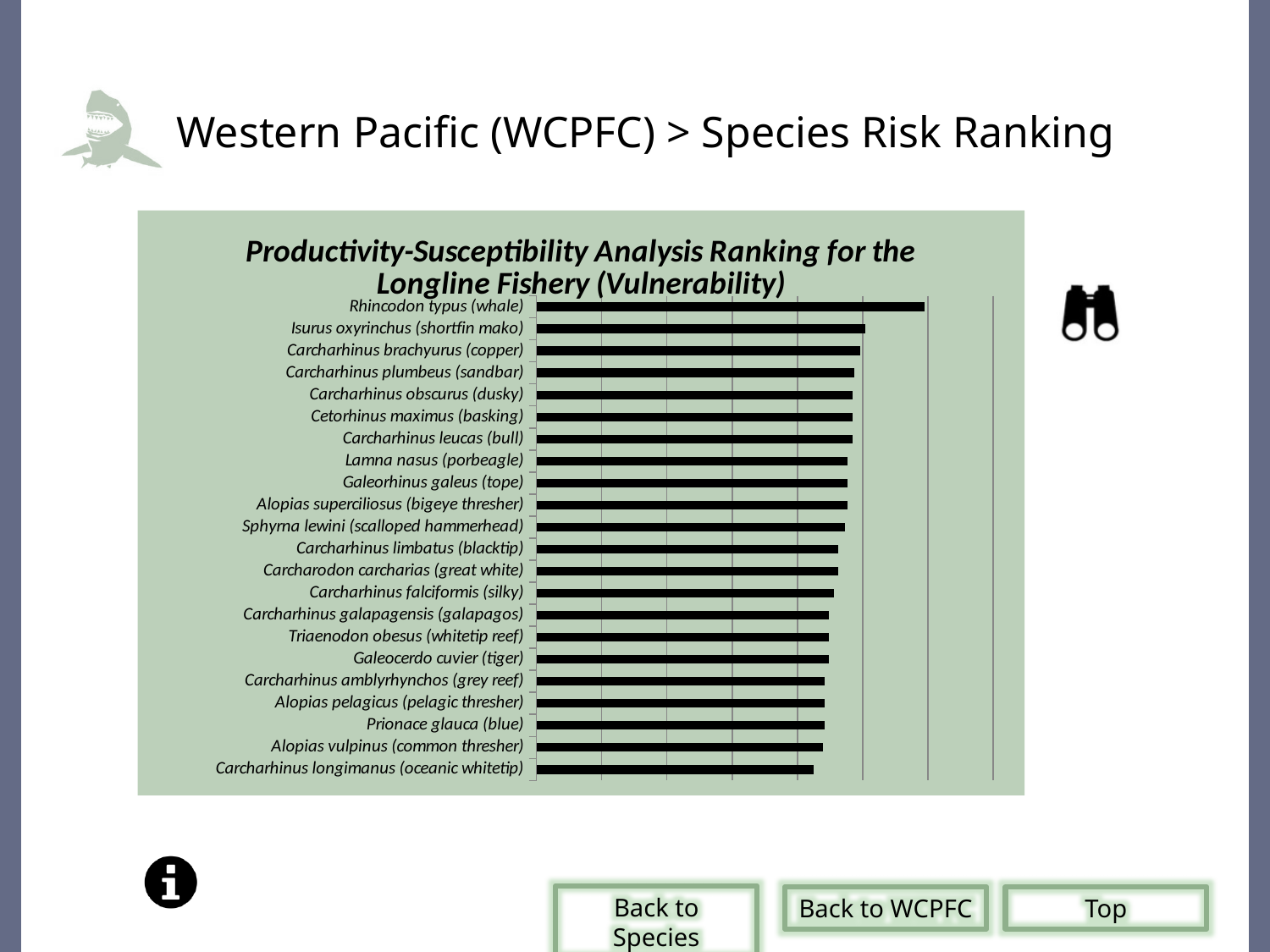
Which has the larger value, Alopias vulpinus (common thresher) or Carcharhinus plumbeus (sandbar)? Carcharhinus plumbeus (sandbar) Which species has the longest bar in the chart? Rhincodon typus (whale) How many species are listed in the chart? 22 What is the title of the chart? Productivity-Susceptibility Analysis Ranking for the Longline Fishery (Vulnerability) Which species has the shortest bar in the chart? Carcharhinus longimanus (oceanic whitetip) What kind of chart is shown on the slide? bar chart Which has the larger value, Rhincodon typus (whale) or Carcharhinus longimanus (oceanic whitetip)? Rhincodon typus (whale) Which has the larger value, Carcharhinus brachyurus (copper) or Carcharhinus falciformis (silky)? Carcharhinus brachyurus (copper) Do the bar lengths generally increase or decrease going from the top of the chart to the bottom? decrease Which species is listed at the top of the chart? Rhincodon typus (whale)